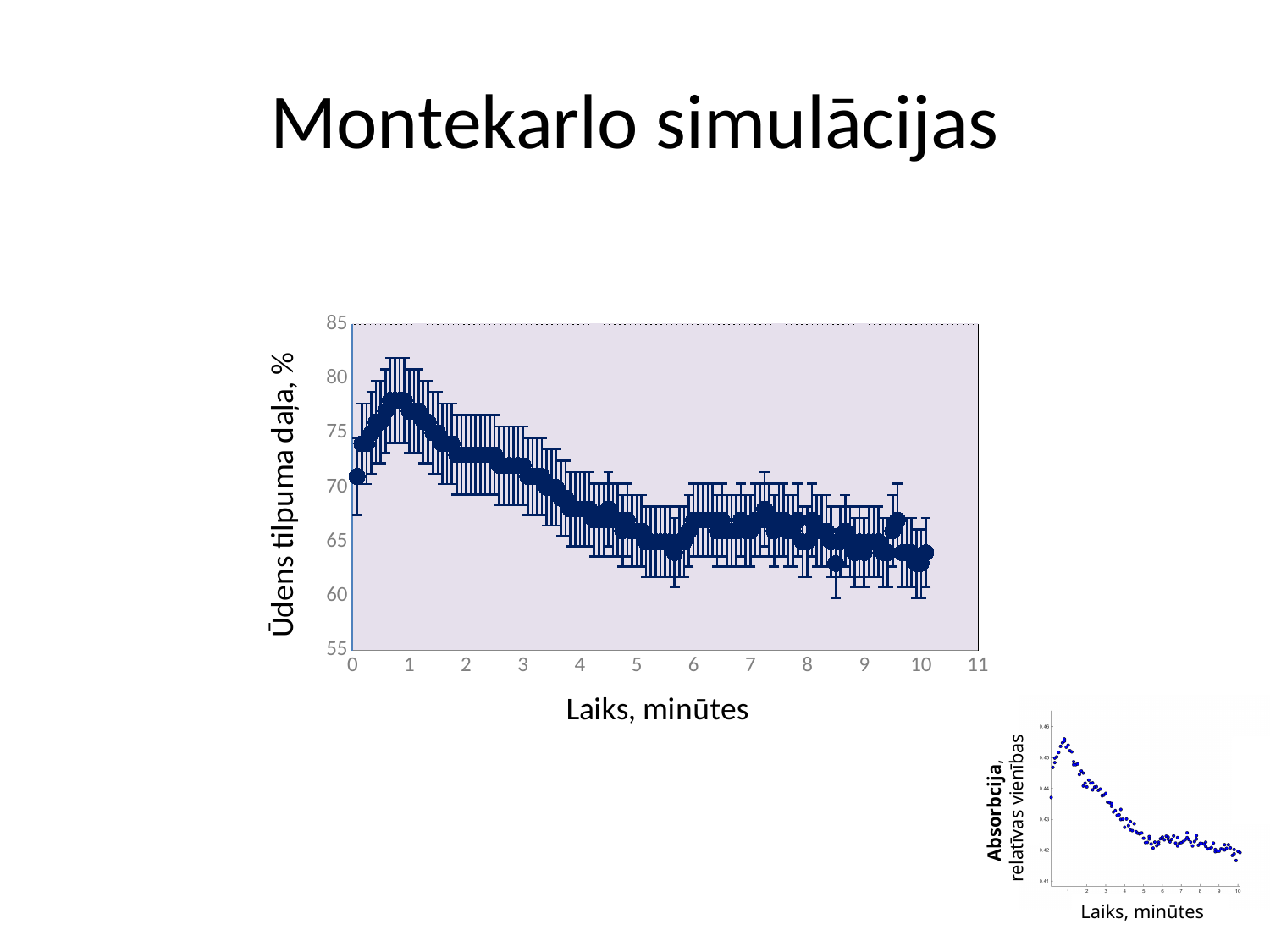
In the small chart in the bottom-right corner, do the values rise or fall between 1 minute and 10 minutes? fall In the large chart on the left, is the value at 10 minutes greater or less than 65? less In the large chart on the left, is the peak value reached near 1 minute greater or less than 75? greater In the large chart on the left, what is the title of the horizontal axis? Laiks, minūtes In the large chart on the left, do the values rise or fall between 1 minute and 10 minutes? fall What kind of chart is the large chart on the left of the slide? scatter chart with error bars What kind of chart is the small chart in the bottom-right corner of the slide? scatter chart In the large chart on the left, what is the title of the vertical axis? Ūdens tilpuma daļa, % In the large chart on the left, is the value at 3 minutes greater or less than 70? greater In the large chart on the left, do the values rise or fall between 0 and 1 minute? rise